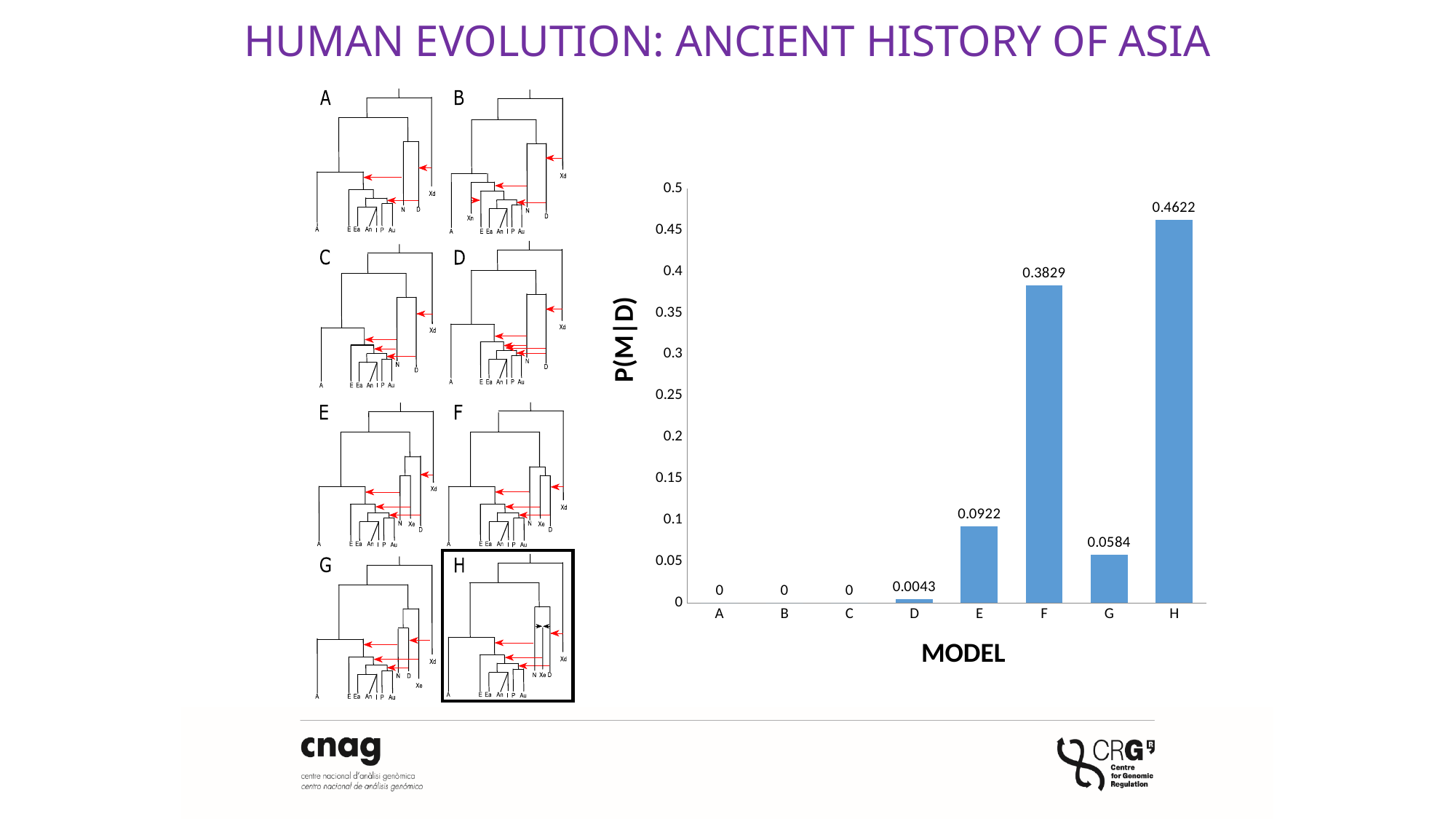
Is the value for model F greater or less than 0.4? less What is the P(M|D) value for model G? 0.0584 What is the P(M|D) value for model D? 0.0043 Which model has the highest P(M|D)? H What kind of chart is used to show P(M|D) by model? bar chart How many models are shown on the x axis of the bar chart? 8 What is the P(M|D) value for model H? 0.4622 What is the difference in P(M|D) between model H and model F? 0.0793 Which has a larger P(M|D), model E or model G? E What is the label of the y axis of the bar chart? P(M|D) What is the P(M|D) value for model F? 0.3829 What is the difference in P(M|D) between model E and model G? 0.0338